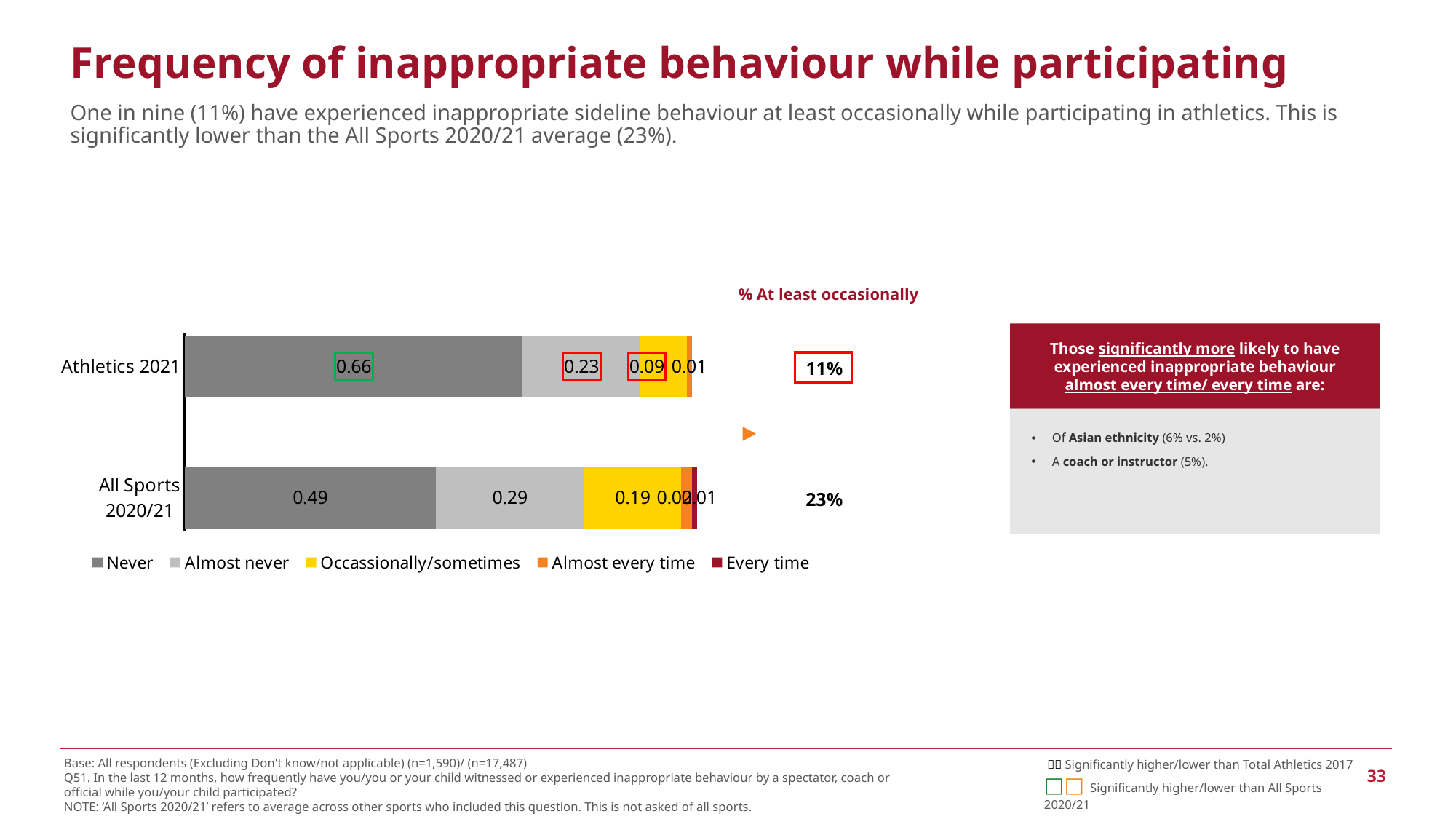
What is the value of the Almost never segment for All Sports 2020/21? 0.29 What is the value of the Never segment for Athletics 2021? 0.66 How many series does the legend list? 5 What is the value of the Occassionally/sometimes segment for Athletics 2021? 0.09 What is the value of the Occassionally/sometimes segment for All Sports 2020/21? 0.19 Which segment is the largest in the All Sports 2020/21 bar? Never What is the difference between the Never values for Athletics 2021 and All Sports 2020/21? 0.17 What is the '% At least occasionally' figure shown for Athletics 2021? 11% What kind of chart is shown on the slide? Stacked bar chart What is the difference between the Occassionally/sometimes values for All Sports 2020/21 and Athletics 2021? 0.10 How many categories (bars) are shown in the chart? 2 Which has the larger Never value, Athletics 2021 or All Sports 2020/21? Athletics 2021